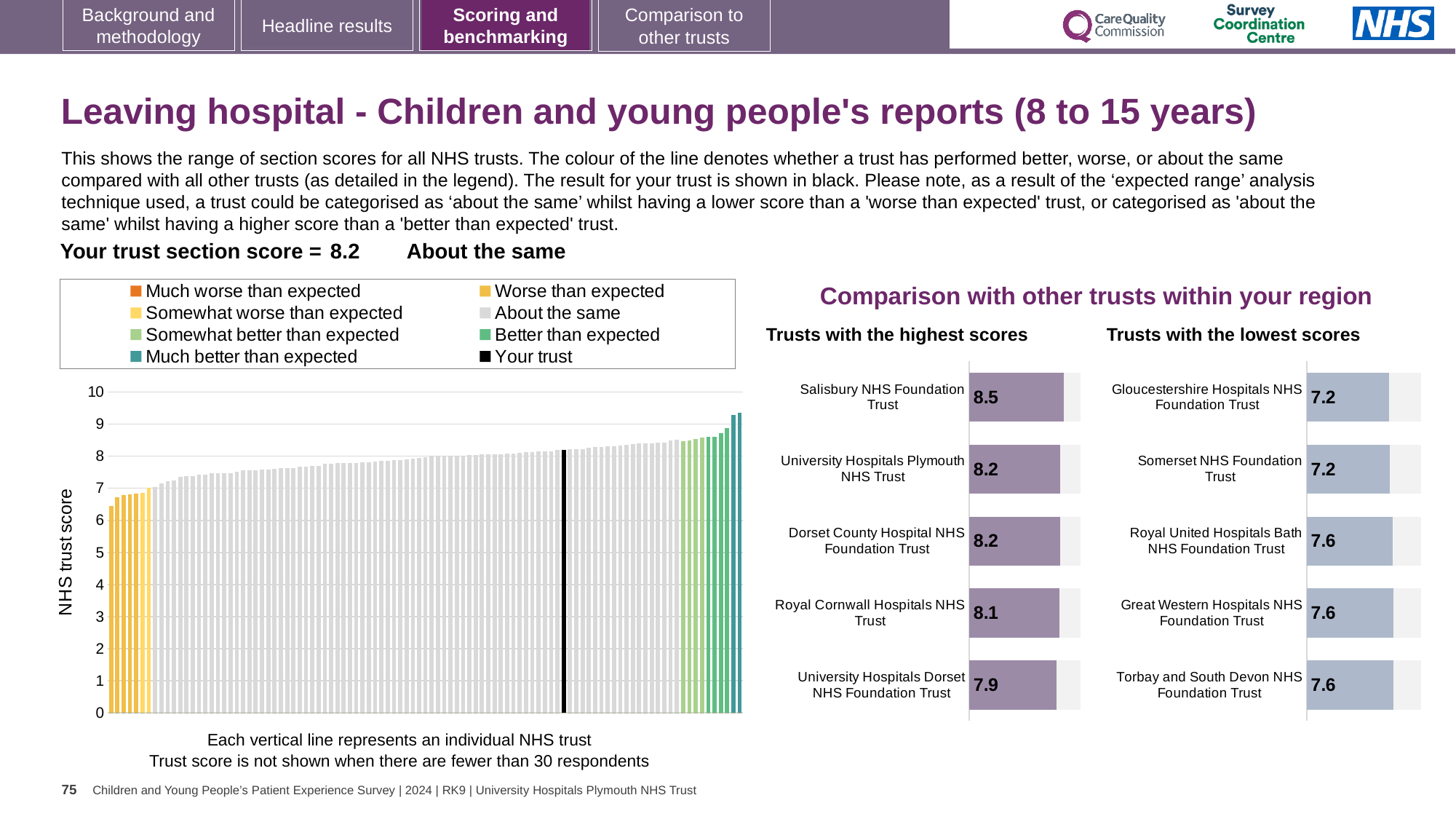
How many entries does the legend of the large chart on the left list? 8 In the 'Trusts with the lowest scores' chart, what is the score for Royal United Hospitals Bath NHS Foundation Trust? 7.6 In the large chart on the left showing the range of section scores, do the values rise or fall from left to right? rise In the 'Trusts with the highest scores' chart, what is the score for Salisbury NHS Foundation Trust? 8.5 In the 'Trusts with the highest scores' chart, which trust has the lowest score? University Hospitals Dorset NHS Foundation Trust In the 'Trusts with the highest scores' chart, what is the difference between the scores of Salisbury NHS Foundation Trust and University Hospitals Dorset NHS Foundation Trust? 0.6 In the 'Trusts with the lowest scores' chart, what is the difference between the scores of Torbay and South Devon NHS Foundation Trust and Somerset NHS Foundation Trust? 0.4 In the 'Trusts with the highest scores' chart, which has the larger score: Royal Cornwall Hospitals NHS Trust or University Hospitals Dorset NHS Foundation Trust? Royal Cornwall Hospitals NHS Trust How many trusts are shown in the 'Trusts with the lowest scores' chart? 5 In the 'Trusts with the highest scores' chart, what is the score for University Hospitals Dorset NHS Foundation Trust? 7.9 In the 'Trusts with the highest scores' chart, which trust has the highest score? Salisbury NHS Foundation Trust In the large chart on the left showing the range of section scores, is the value of the lowest bar greater or less than 7? less